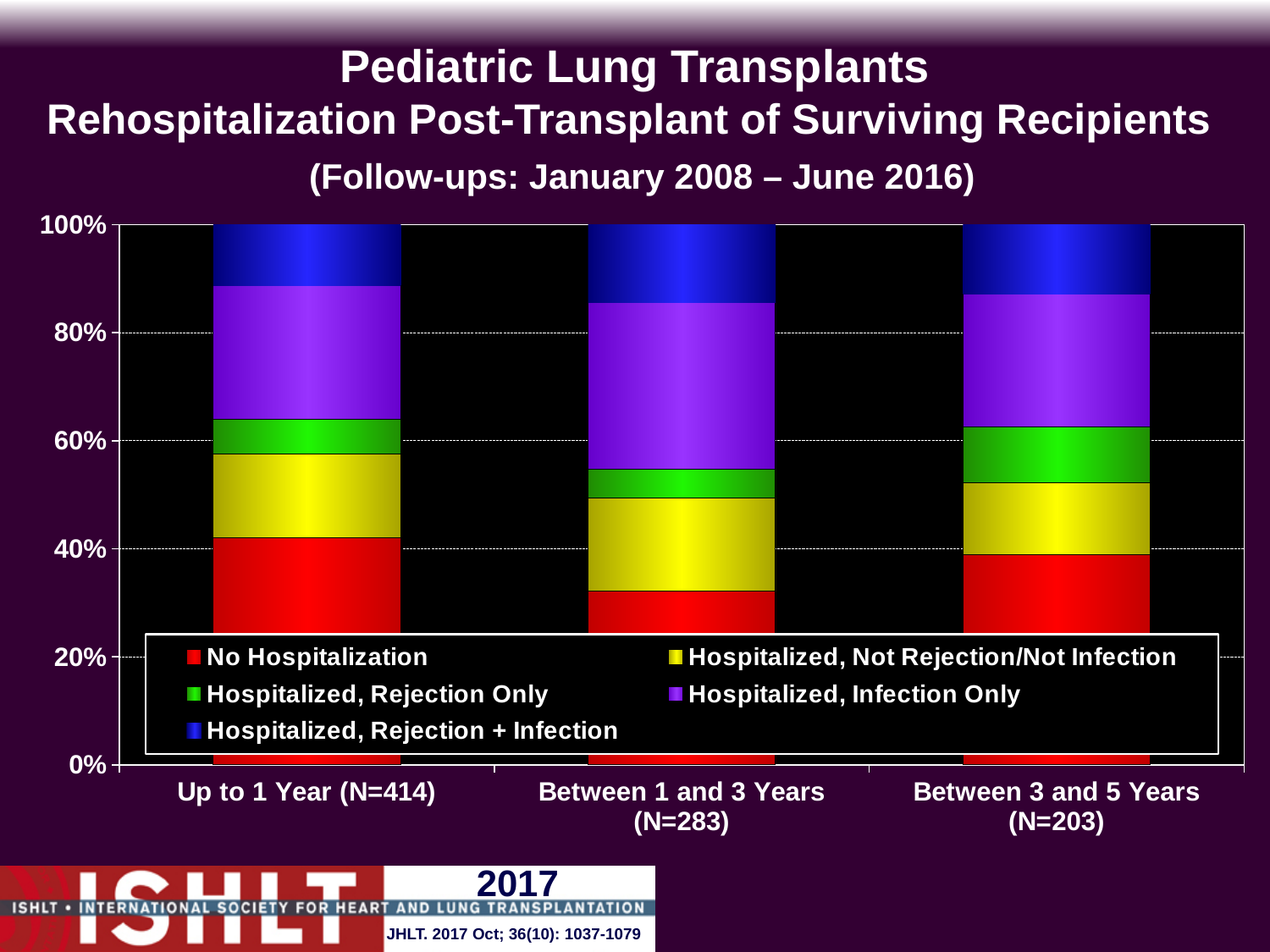
Which follow-up category has the smallest No Hospitalization segment? Between 1 and 3 Years (N=283) Which follow-up category has the largest No Hospitalization segment? Up to 1 Year (N=414) How many series does the legend list? 5 Is the No Hospitalization share for Between 1 and 3 Years greater or less than 40%? less What kind of chart is shown on the slide? Stacked bar chart Is the No Hospitalization share for Up to 1 Year greater or less than 20%? greater Which has a larger No Hospitalization share: Up to 1 Year or Between 1 and 3 Years? Up to 1 Year Which colour represents Hospitalized, Rejection + Infection in the legend? Blue What is the N for the Between 3 and 5 Years category? 203 How many follow-up categories are shown on the x axis? 3 Which follow-up category has the largest Hospitalized, Rejection Only segment? Between 3 and 5 Years (N=203) Which follow-up category has the largest Hospitalized, Infection Only segment? Between 1 and 3 Years (N=283)